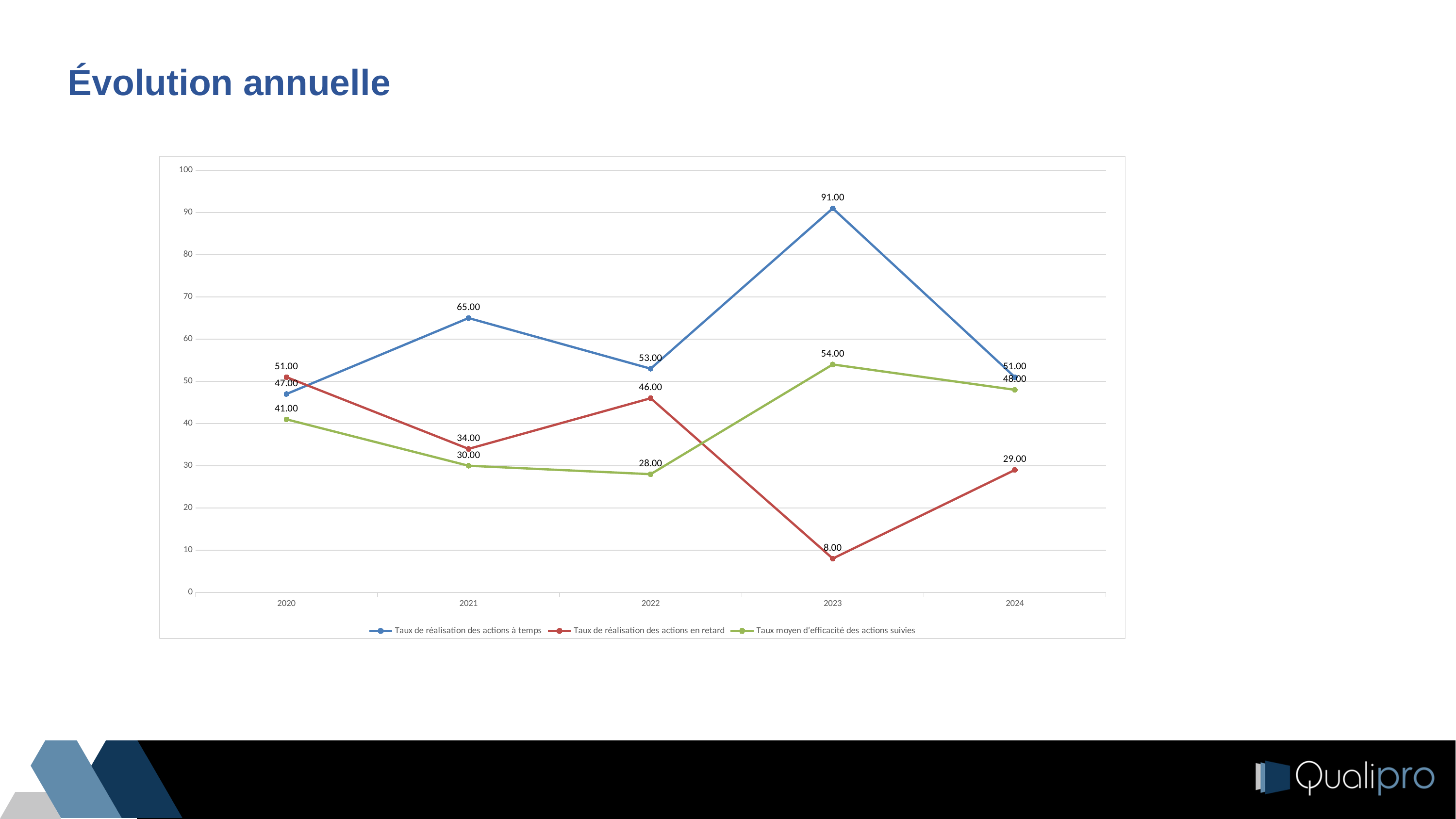
How many years are shown on the x axis? 5 Does 'Taux moyen d'efficacité des actions suivies' rise or fall from 2022 to 2023? rise What type of chart is shown on the slide? line chart What is the title of the slide containing the chart? Évolution annuelle In which year is 'Taux de réalisation des actions en retard' lowest? 2023 What is the value of 'Taux de réalisation des actions à temps' in 2023? 91.00 What is the value of 'Taux de réalisation des actions en retard' in 2022? 46.00 Which is larger in 2020: 'Taux de réalisation des actions à temps' or 'Taux de réalisation des actions en retard'? Taux de réalisation des actions en retard How many series does the legend list? 3 What is the difference between 'Taux de réalisation des actions à temps' and 'Taux de réalisation des actions en retard' in 2023? 83.00 What is the value of 'Taux moyen d'efficacité des actions suivies' in 2021? 30.00 In which year is 'Taux de réalisation des actions à temps' highest? 2023